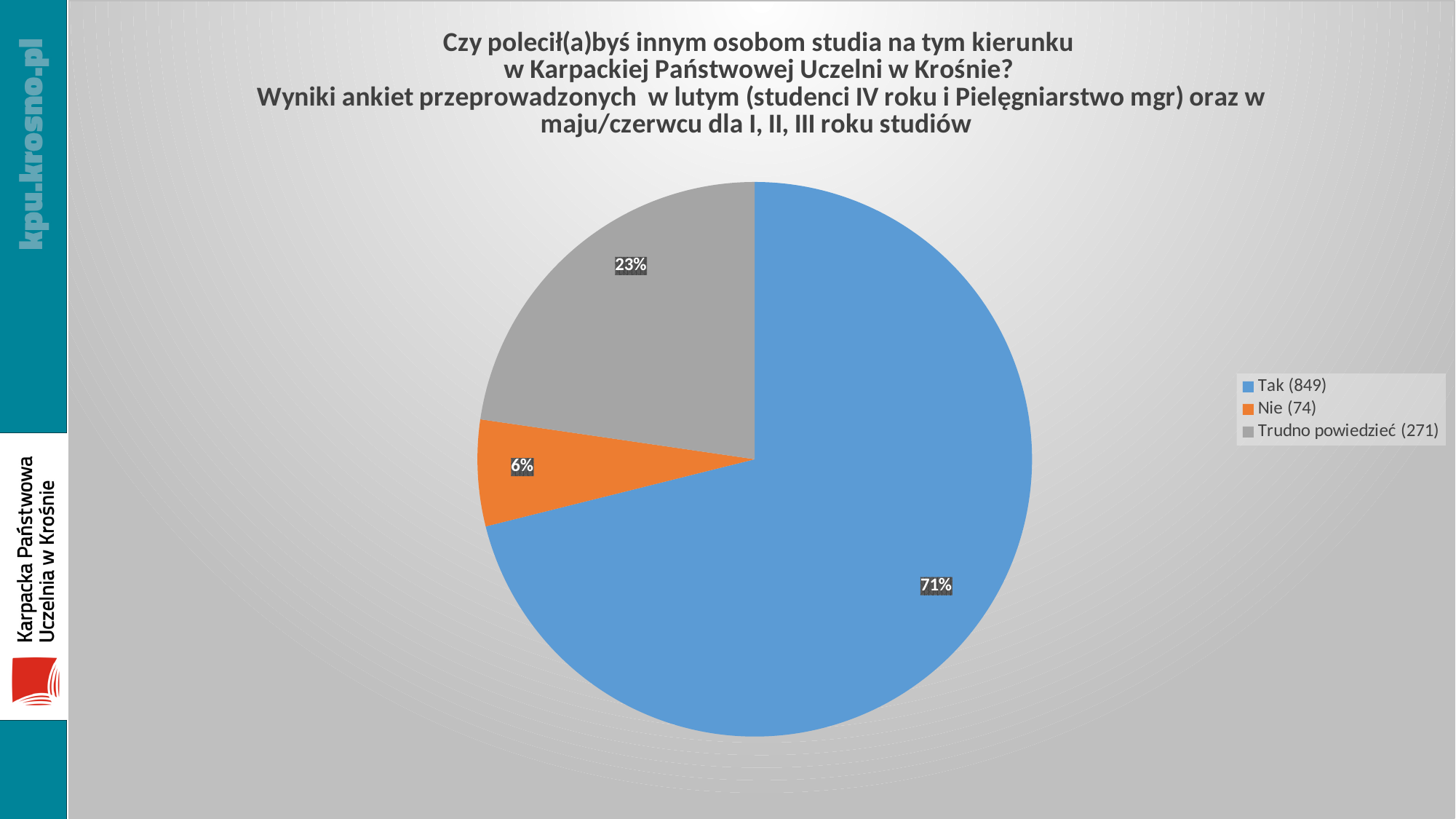
Which slice is larger: "Nie (74)" or "Trudno powiedzieć (271)"? Trudno powiedzieć (271) Which category has the smallest slice of the pie? Nie (74) What percentage share does the "Nie (74)" slice have? 6% What percentage share does the "Tak (849)" slice have? 71% What colour is the "Tak (849)" slice? blue How many entries does the legend list? 3 What kind of chart is shown on the slide? pie chart Which category has the largest slice of the pie? Tak (849) What percentage share does the "Trudno powiedzieć (271)" slice have? 23% What is the difference in percentage points between the "Tak (849)" slice and the "Trudno powiedzieć (271)" slice? 48% How many slices does the pie chart have? 3 What colour is the "Nie (74)" slice? orange